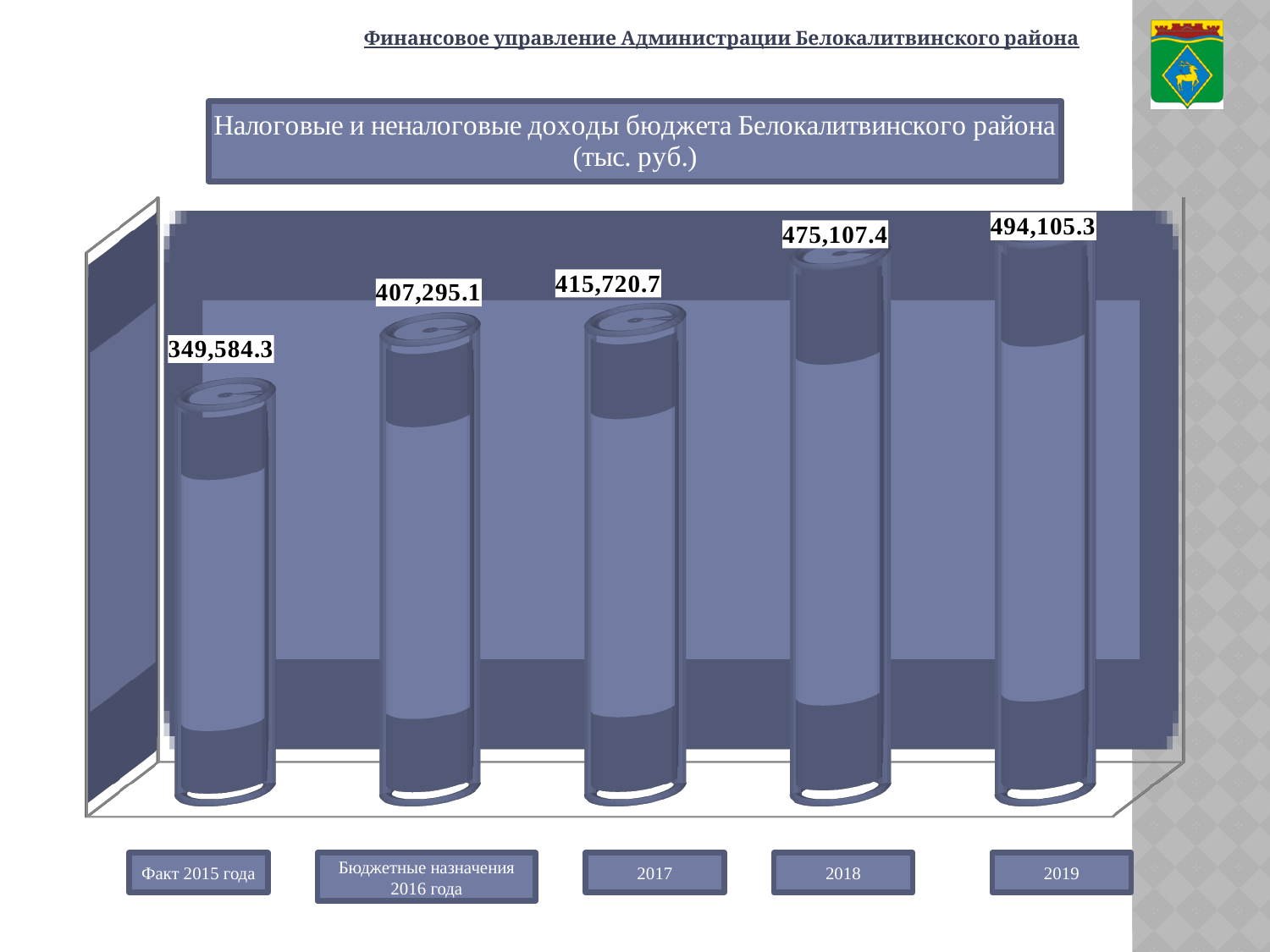
How many categories are shown in the chart? 5 What is the value for 2018? 475,107.4 What is the value for 2017? 415,720.7 What is the value for Бюджетные назначения 2016 года? 407,295.1 Which category has the highest value? 2019 What is the difference between the values for 2019 and Факт 2015 года? 144,521.0 Which category has the lowest value? Факт 2015 года Which is larger, the value for 2017 or the value for Бюджетные назначения 2016 года? 2017 Do the values rise or fall from Факт 2015 года to 2019? rise What is the value for Факт 2015 года? 349,584.3 What is the value for 2019? 494,105.3 What is the difference between the values for 2018 and 2017? 59,386.7